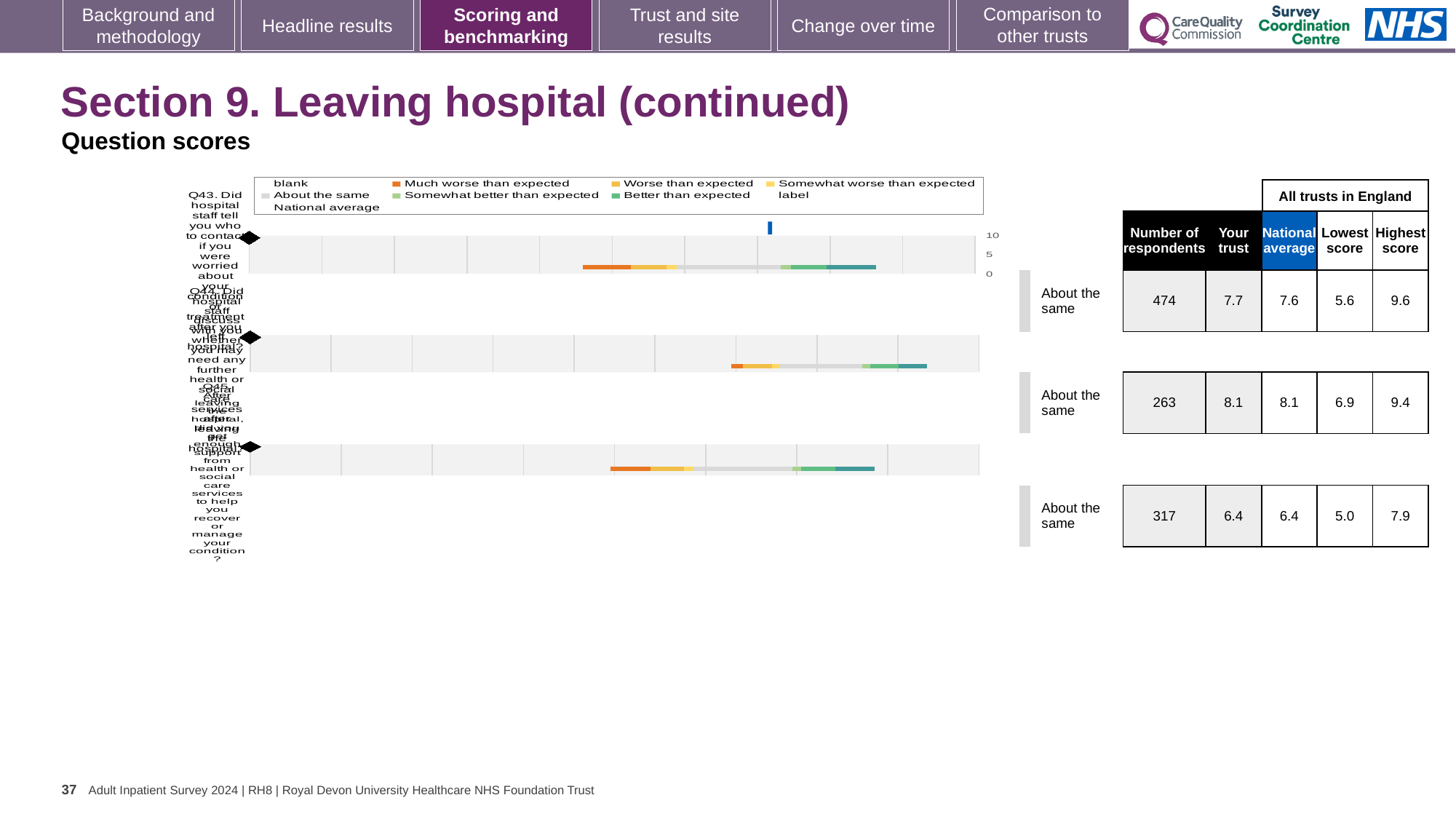
For the second chart (Q44), what is the national average score? 8.1 Which of the three charts has the lowest 'Your trust' score? the third chart (Q45), 6.4 What is the maximum value shown on the score axis of the charts? 10 Which of the three charts has the highest 'Your trust' score? the second chart (Q44), 8.1 For the first chart (Q43), which is larger: the 'Your trust' score or the national average? Your trust For the first chart (Q43), what is the 'Your trust' score? 7.7 For the third chart (Q45), what is the difference between the highest score and the lowest score across all trusts in England? 2.9 What benchmark category is shown beside each of the three charts? About the same For the first chart (Q43), what is the lowest score among all trusts in England? 5.6 How many question score charts (rows) are shown on the slide? 3 What kind of chart is used to show the question scores on this slide? bar chart For the first chart (Q43, who to contact if worried after leaving hospital), what is the number of respondents shown in the table? 474